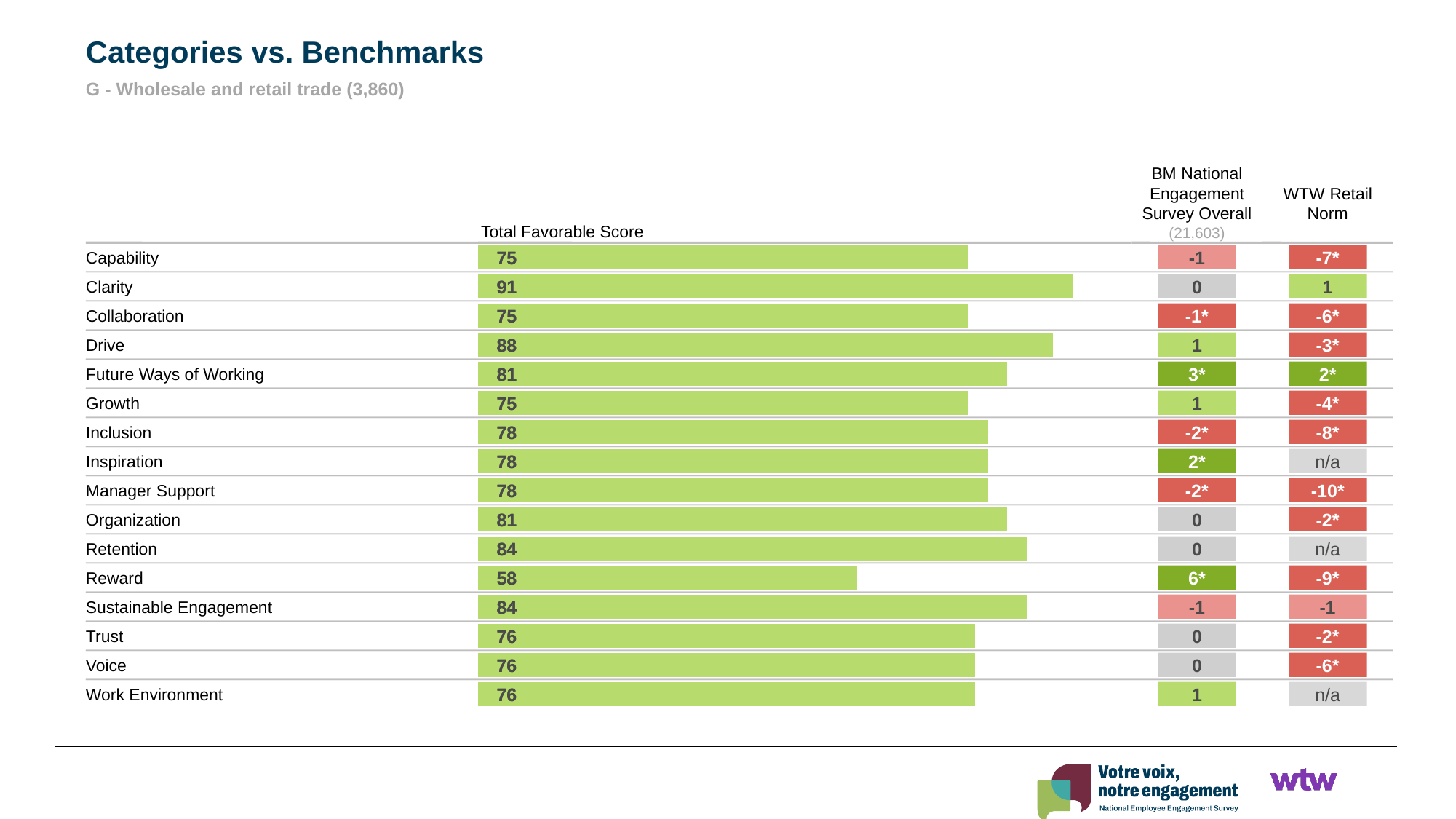
What is the difference between the Total Favorable Scores for Future Ways of Working and Capability? 6 What is the difference between the Total Favorable Scores for Clarity and Reward? 33 Which has a higher Total Favorable Score, Drive or Retention? Drive What is the BM National Engagement Survey Overall difference shown for Reward? 6* What kind of chart is used to show the Total Favorable Score? Bar chart What is the Total Favorable Score for Reward? 58 What is the title of the slide containing the chart? Categories vs. Benchmarks What is the Total Favorable Score for Clarity? 91 How many categories are shown in the chart? 16 Which category has the lowest Total Favorable Score? Reward Which category has the highest Total Favorable Score? Clarity What is the WTW Retail Norm difference shown for Manager Support? -10*